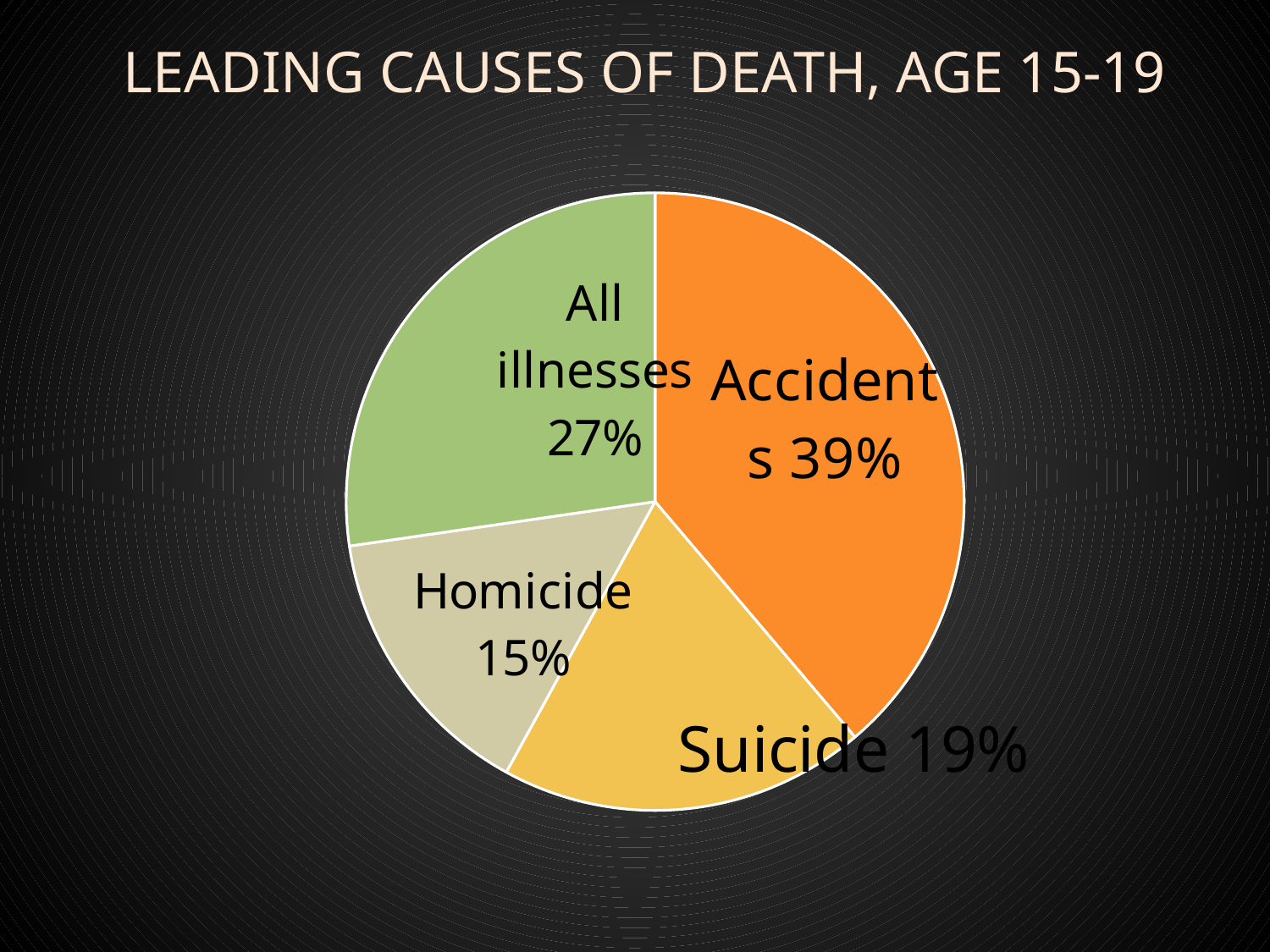
Which cause of death has the smallest share of the pie? Homicide What percentage of the pie is Homicide? 15% What percentage of the pie is Suicide? 19% What is the title of the chart? LEADING CAUSES OF DEATH, AGE 15-19 Which cause of death has the largest share of the pie? Accidents Which is larger, the share for All illnesses or the share for Suicide? All illnesses What kind of chart is shown on the slide? Pie chart What colour is the Accidents slice? Orange How many slices does the pie chart have? 4 What percentage of the pie is All illnesses? 27% What is the difference in percentage points between Accidents and Suicide? 20 What percentage of the pie is Accidents? 39%